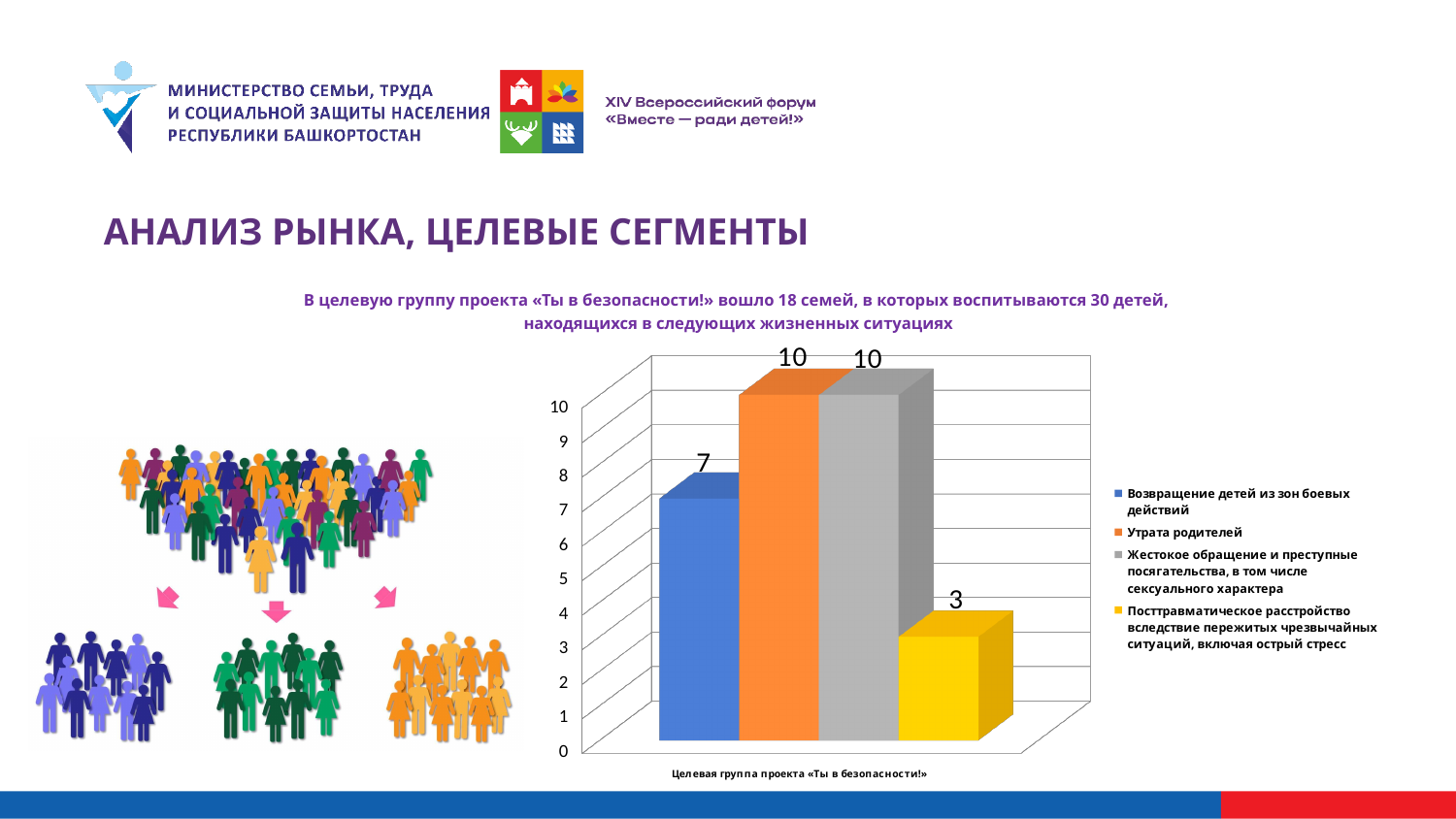
What is the value for «Возвращение детей из зон боевых действий»? 7 Is the value for «Возвращение детей из зон боевых действий» greater or less than 5? greater Which is larger: the value for «Возвращение детей из зон боевых действий» or the value for «Посттравматическое расстройство»? Возвращение детей из зон боевых действий Which series has the lowest value? Посттравматическое расстройство вследствие пережитых чрезвычайных ситуаций, включая острый стресс How many series does the legend list? 4 What is the value for «Посттравматическое расстройство вследствие пережитых чрезвычайных ситуаций, включая острый стресс»? 3 What is the difference between the value for «Утрата родителей» and the value for «Возвращение детей из зон боевых действий»? 3 What is the value for «Жестокое обращение и преступные посягательства, в том числе сексуального характера»? 10 What kind of chart is shown on the slide? bar chart What is the sum of the four values shown in the chart? 30 What is the value for «Утрата родителей»? 10 What is the difference between the value for «Возвращение детей из зон боевых действий» and the value for «Посттравматическое расстройство»? 4